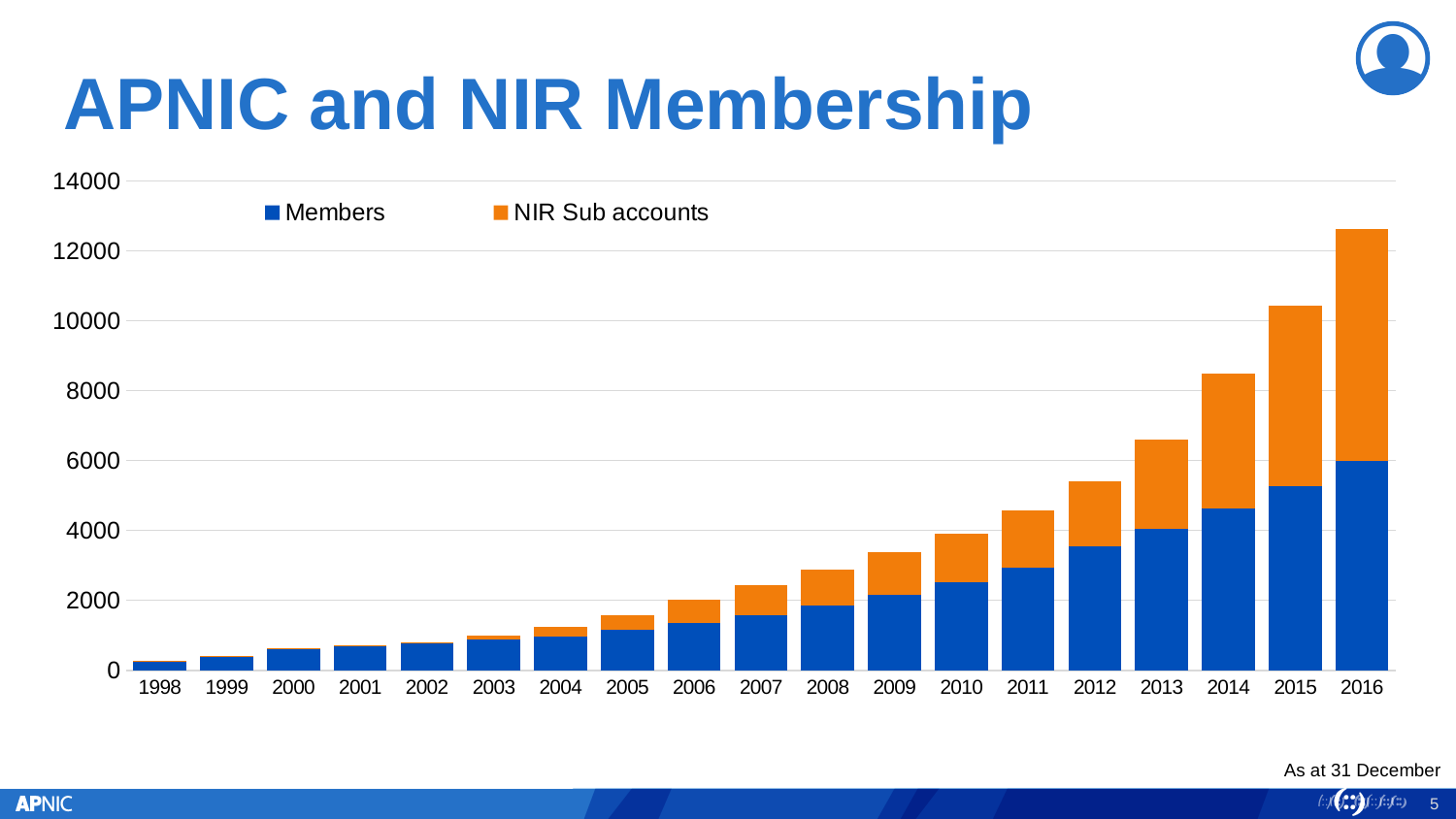
How many series does the legend list? 2 Is the total stacked bar for 2016 greater or less than 12000? greater Which year has the tallest stacked bar? 2016 Which year has the shortest stacked bar? 1998 Is the total stacked bar for 2009 greater or less than 4000? less What kind of chart is shown on the slide? stacked bar chart Is the Members value for 2011 greater or less than 4000? less Do the stacked bar totals rise or fall from 1998 to 2016? rise How many years are shown along the x axis? 19 What are the two series named in the legend? Members and NIR Sub accounts Which year has the larger Members value, 2014 or 2012? 2014